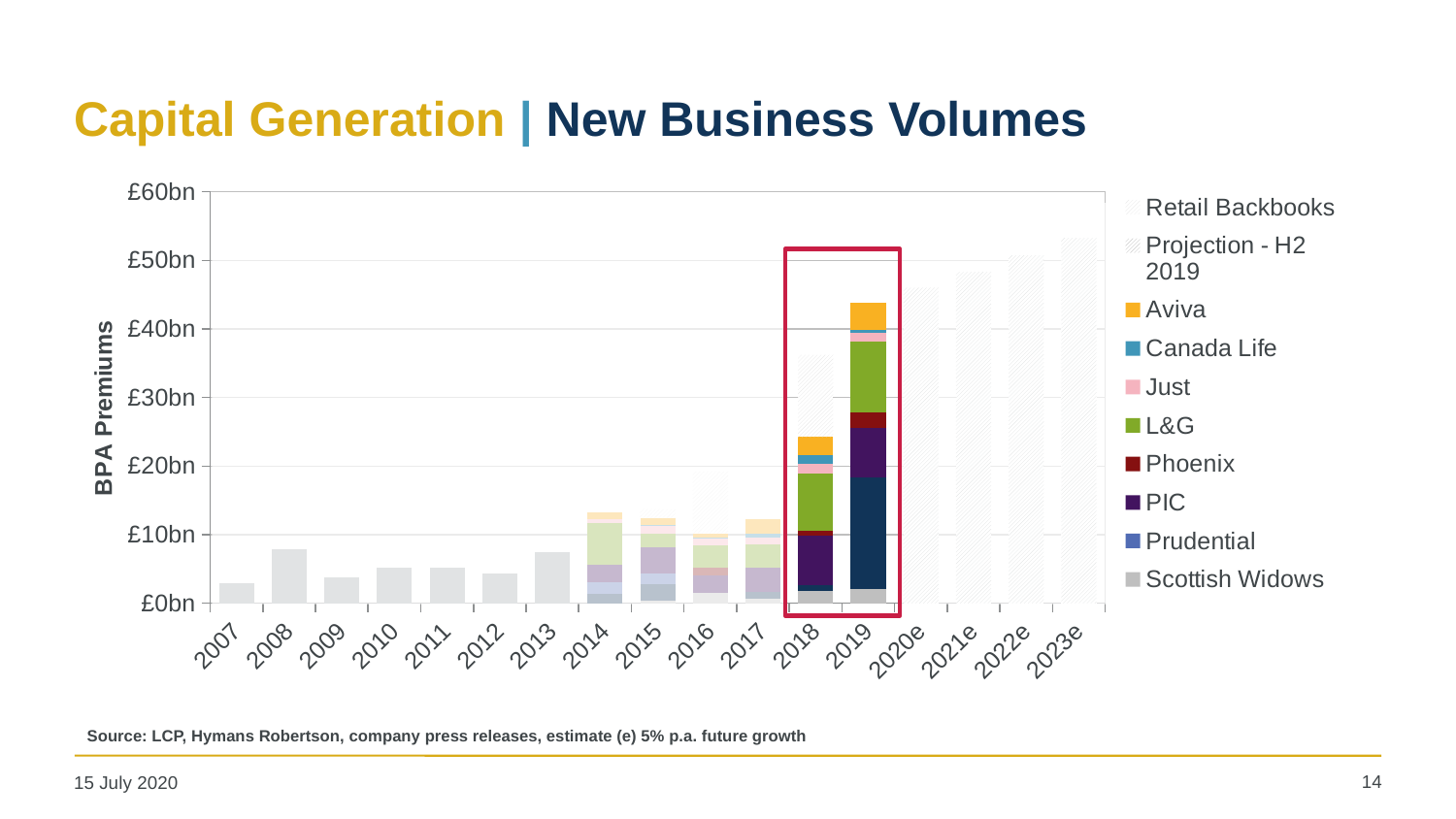
How many years (categories) are shown on the x axis? 17 Is the total value for 2020e greater or less than £50bn? less How many series does the legend list? 10 Do the total BPA premiums rise or fall from 2018 to 2023e? Rise What is the label on the vertical axis of the chart? BPA Premiums What kind of chart is shown on the slide? Stacked bar chart Which year has the larger total BPA premiums, 2018 or 2019? 2019 Which year has the highest total BPA premiums? 2023e Is the total value for 2019 greater or less than £40bn? greater Is the total value for 2018 greater or less than £20bn? greater Which year has the lowest total BPA premiums? 2007